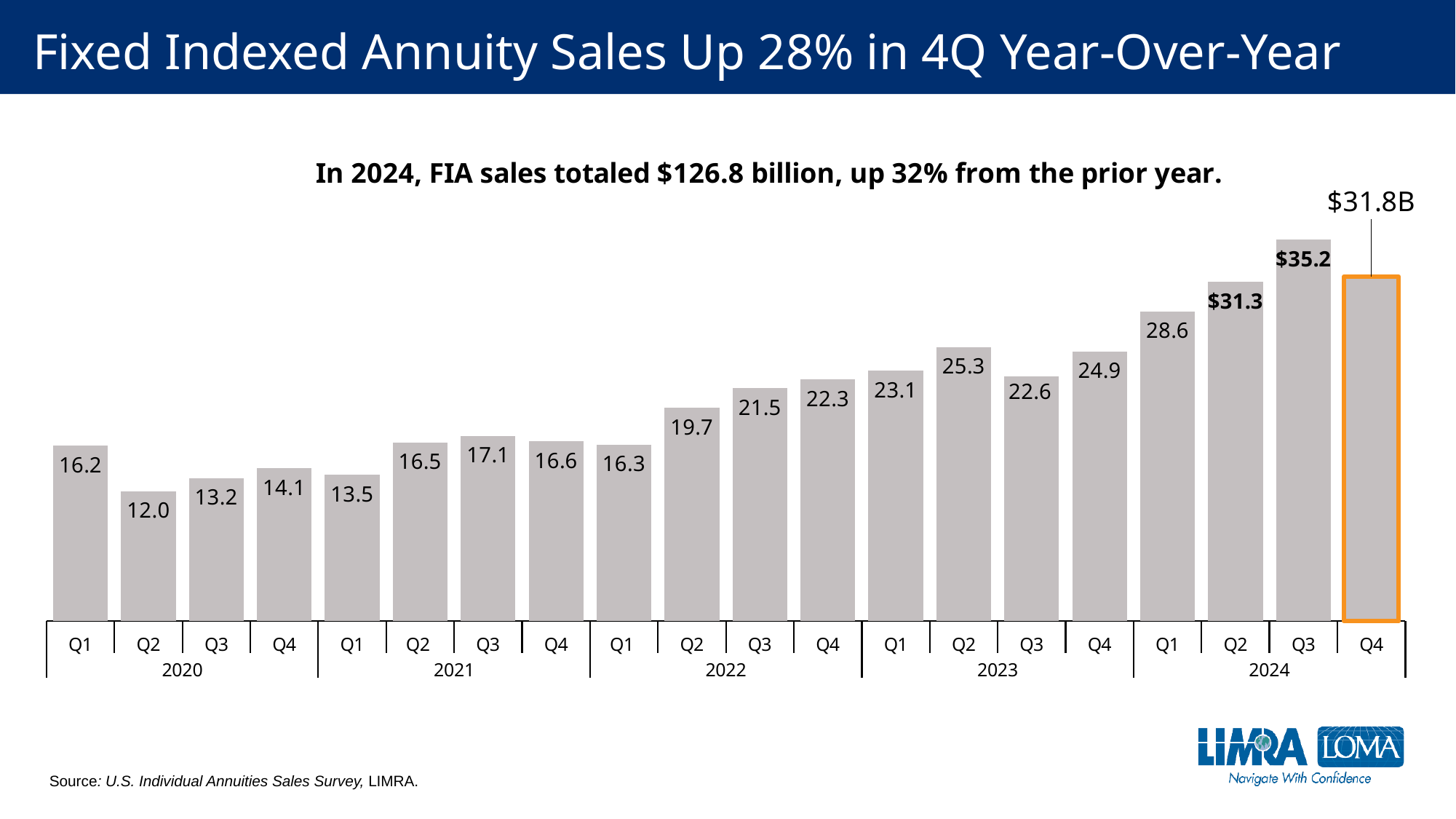
What is the value for Q1 2020? 16.2 Which quarter has the lowest value? Q2 2020 What is the difference between Q4 2023 and Q4 2022? 2.6 Do the values generally rise or fall from 2020 to 2024? Rise How many bars are plotted in the chart? 20 What is the difference between Q3 2024 and Q2 2024? 3.9 What is the value for Q3 2024? $35.2 What is the value for Q4 2024, the highlighted bar? $31.8B What kind of chart is shown on the slide? Bar chart Which is larger, the value for Q3 2023 or the value for Q4 2023? Q4 2023 Which quarter has the highest value? Q3 2024 What is the value for Q2 2022? 19.7